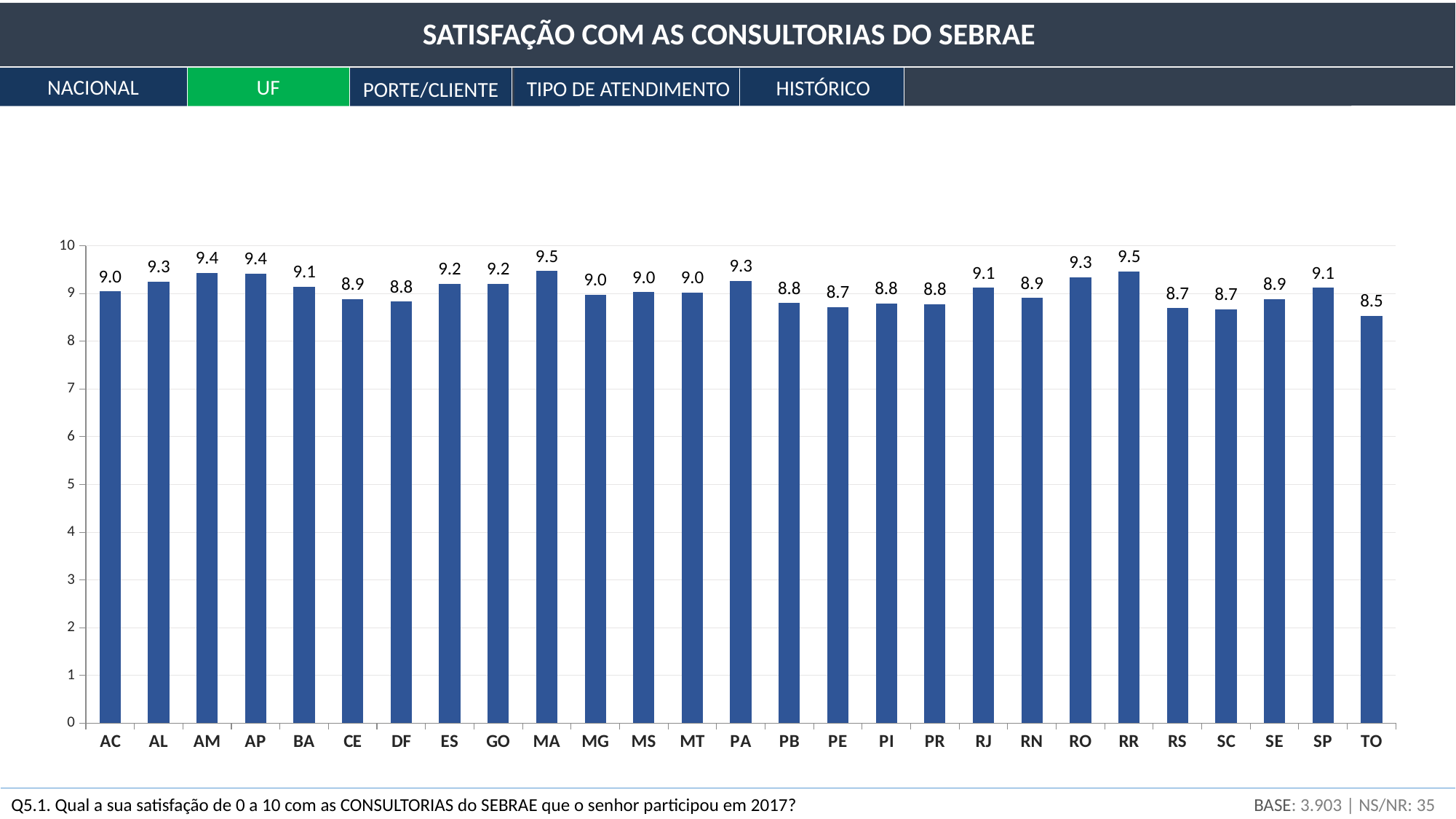
What kind of chart is shown on the slide? Bar chart What is the difference between the values for RR and RS? 0.8 What is the satisfaction value for TO? 8.5 What is the difference between the values for AM and TO? 0.9 Which has a higher value, AL or CE? AL How many states (UFs) are shown on the x axis? 27 What is the title of the slide? SATISFAÇÃO COM AS CONSULTORIAS DO SEBRAE Which has a higher value, PA or PB? PA What is the satisfaction value for PE? 8.7 What is the satisfaction value for SP? 9.1 Which state (UF) has the lowest satisfaction value? TO What is the satisfaction value for MA? 9.5